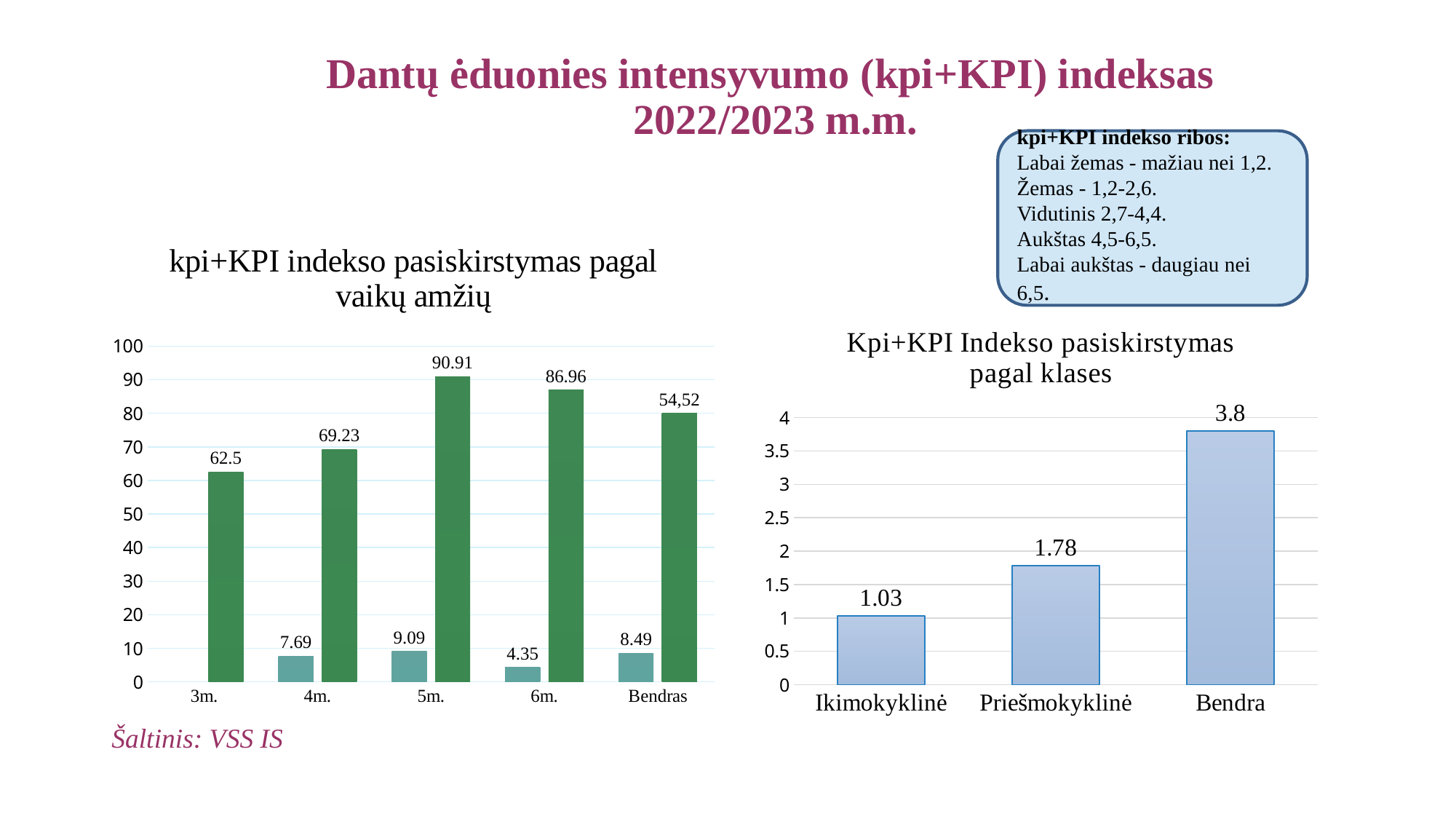
In the chart 'kpi+KPI indekso pasiskirstymas pagal vaikų amžių', what is the value of the teal bar for 6m.? 4.35 In the chart 'kpi+KPI indekso pasiskirstymas pagal vaikų amžių', which is larger, the green bar for 4m. or the green bar for 6m.? 6m. In the chart 'kpi+KPI indekso pasiskirstymas pagal vaikų amžių', which age group has the highest green bar? 5m. In the chart 'kpi+KPI indekso pasiskirstymas pagal vaikų amžių', what is the value of the green bar for 5m.? 90.91 In the chart 'kpi+KPI indekso pasiskirstymas pagal vaikų amžių', what is the difference between the green bars for 5m. and 3m.? 28.41 What type of chart is 'kpi+KPI indekso pasiskirstymas pagal vaikų amžių'? bar chart In the chart 'Kpi+KPI Indekso pasiskirstymas pagal klases', which category has the highest value? Bendra In the chart 'Kpi+KPI Indekso pasiskirstymas pagal klases', what is the difference between Bendra and Ikimokyklinė? 2.77 In the chart 'Kpi+KPI Indekso pasiskirstymas pagal klases', what is the value for Priešmokyklinė? 1.78 In the chart 'Kpi+KPI Indekso pasiskirstymas pagal klases', do the values rise or fall from left to right? rise In the chart 'Kpi+KPI Indekso pasiskirstymas pagal klases', how many categories are shown? 3 In the chart 'Kpi+KPI Indekso pasiskirstymas pagal klases', what is the value for Ikimokyklinė? 1.03